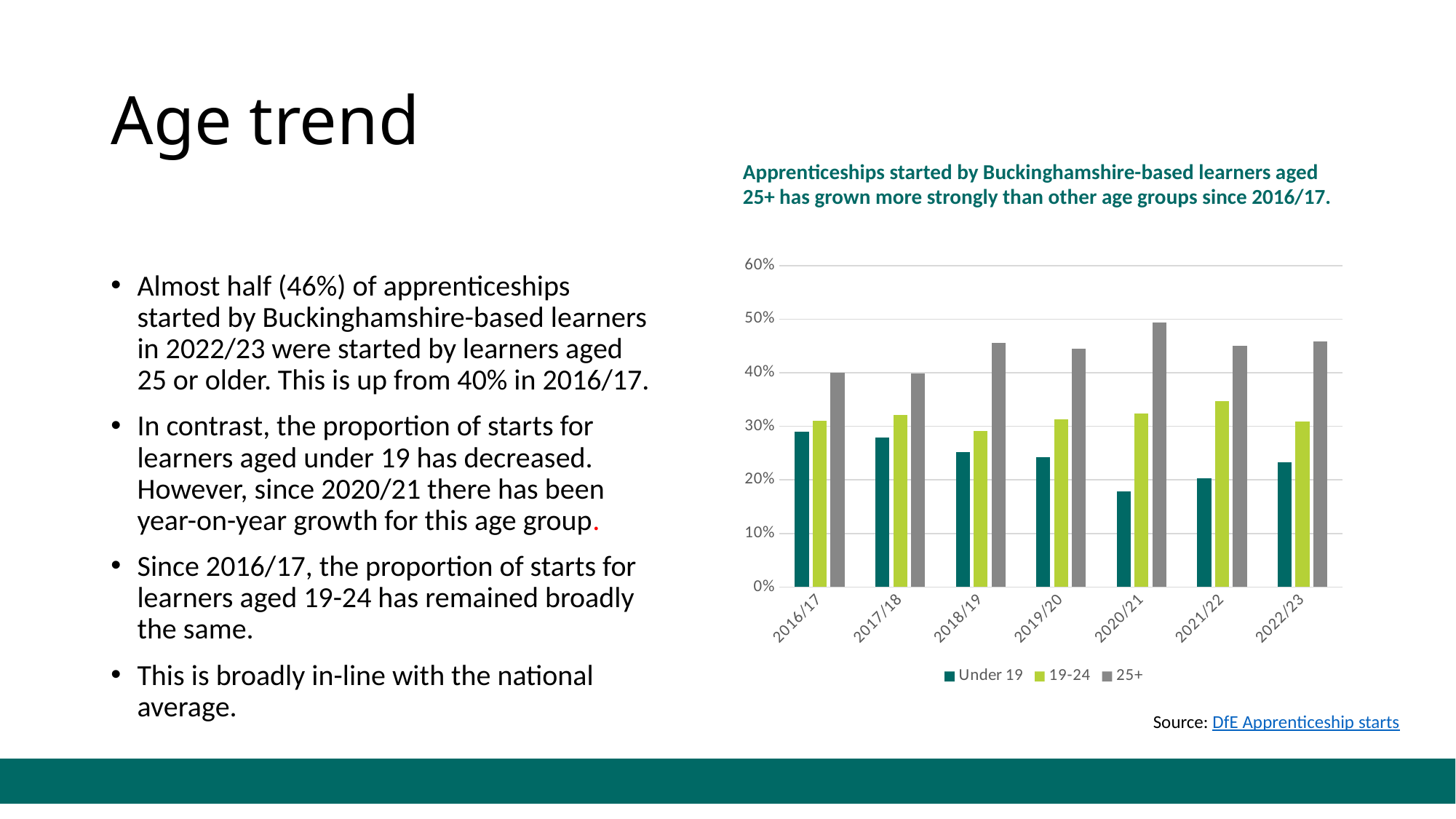
Which series are listed in the chart legend? Under 19, 19-24, 25+ Does the Under 19 series rise or fall from 2016/17 to 2020/21? fall In which year is the 25+ bar the highest? 2020/21 How many academic years are shown on the x axis of the chart? 7 In which year is the Under 19 bar the lowest? 2020/21 In 2022/23, which is larger: the 25+ bar or the Under 19 bar? 25+ Is the value for 19-24 in 2021/22 greater or less than 30%? greater Is the value for Under 19 in 2020/21 greater or less than 20%? less What kind of chart is shown on the slide? bar chart Is the value for 25+ in 2017/18 greater or less than 50%? less How many series does the chart legend list? 3